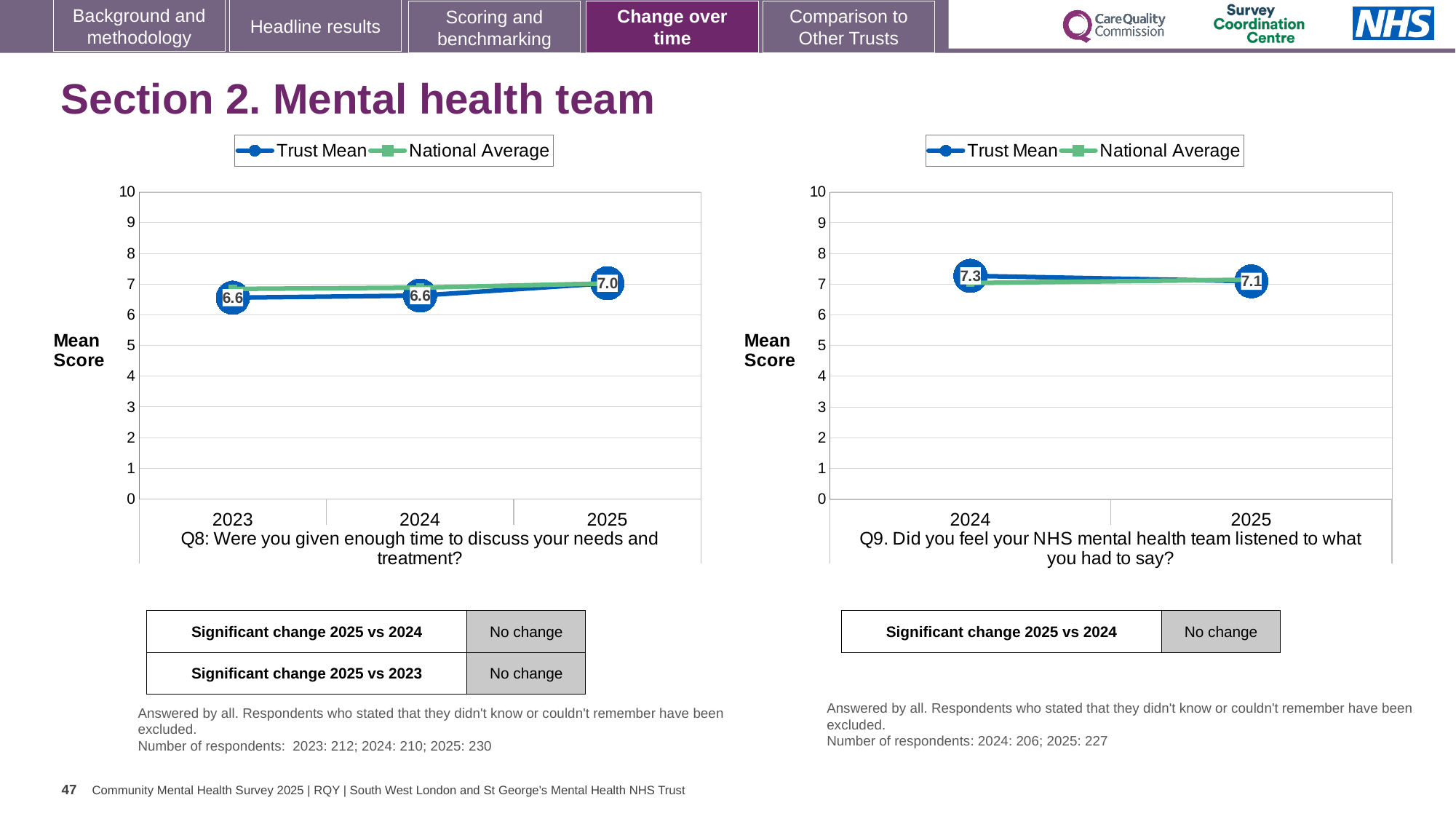
In the Q9 chart on the right, is the Trust Mean higher in 2024 or in 2025? 2024 How many years are plotted on the x axis of the Q8 chart on the left? 3 In the Q8 chart on the left, by how much did the Trust Mean change from 2024 to 2025? 0.4 What kind of chart is the Q8 chart on the left? Line chart How many series does the legend of the Q9 chart on the right list? 2 In the Q9 chart on the right, what is the Trust Mean for 2024? 7.3 In the Q8 chart on the left, what is the Trust Mean for 2025? 7.0 In the Q8 chart on the left, what is the Trust Mean for 2023? 6.6 In the Q8 chart on the left, which year has the highest Trust Mean? 2025 In the Q9 chart on the right, is the National Average for 2025 greater or less than 5? greater In the Q9 chart on the right, what is the Trust Mean for 2025? 7.1 In the Q9 chart on the right, what is the difference between the Trust Mean in 2024 and in 2025? 0.2